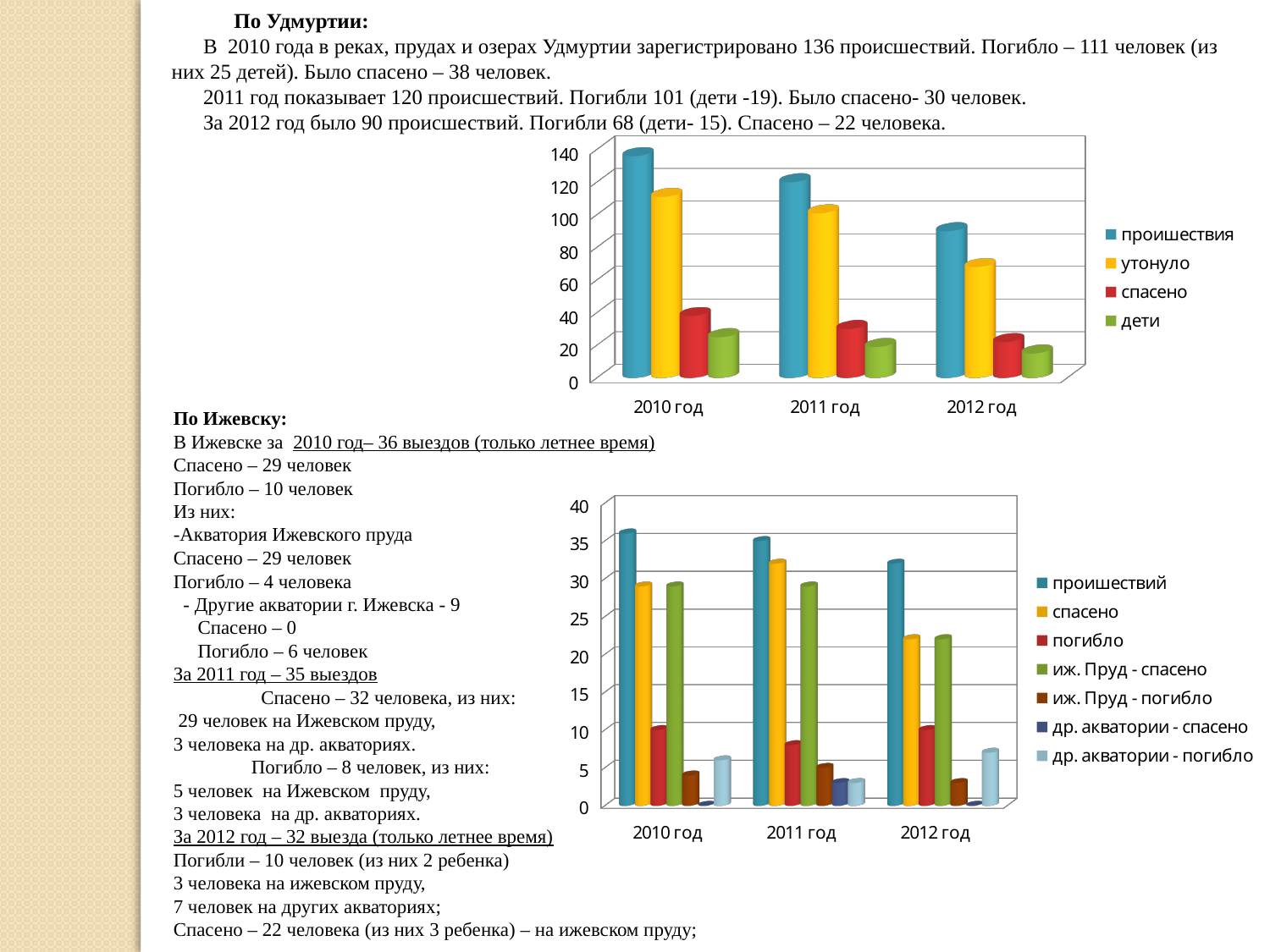
How many series does the legend of the top chart list? 4 In the bottom chart, which year has the lowest value for спасено? 2012 год In the top chart, which year has the highest value for утонуло? 2010 год In the top chart, do the values for проишествия rise or fall from 2010 год to 2012 год? fall In the bottom chart, what colour represents the series иж. Пруд - спасено? green How many year categories are shown on the x axis of the top chart? 3 In the top chart, is the value for утонуло in 2012 год greater or less than 80? less How many series does the legend of the bottom chart list? 7 In the bottom chart, is the value for погибло in 2010 год greater or less than 15? less In the top chart, is the value for проишествия in 2010 год greater or less than 120? greater In the top chart, which is larger for 2010 год: спасено or дети? спасено What kind of chart is the top chart on the slide? bar chart